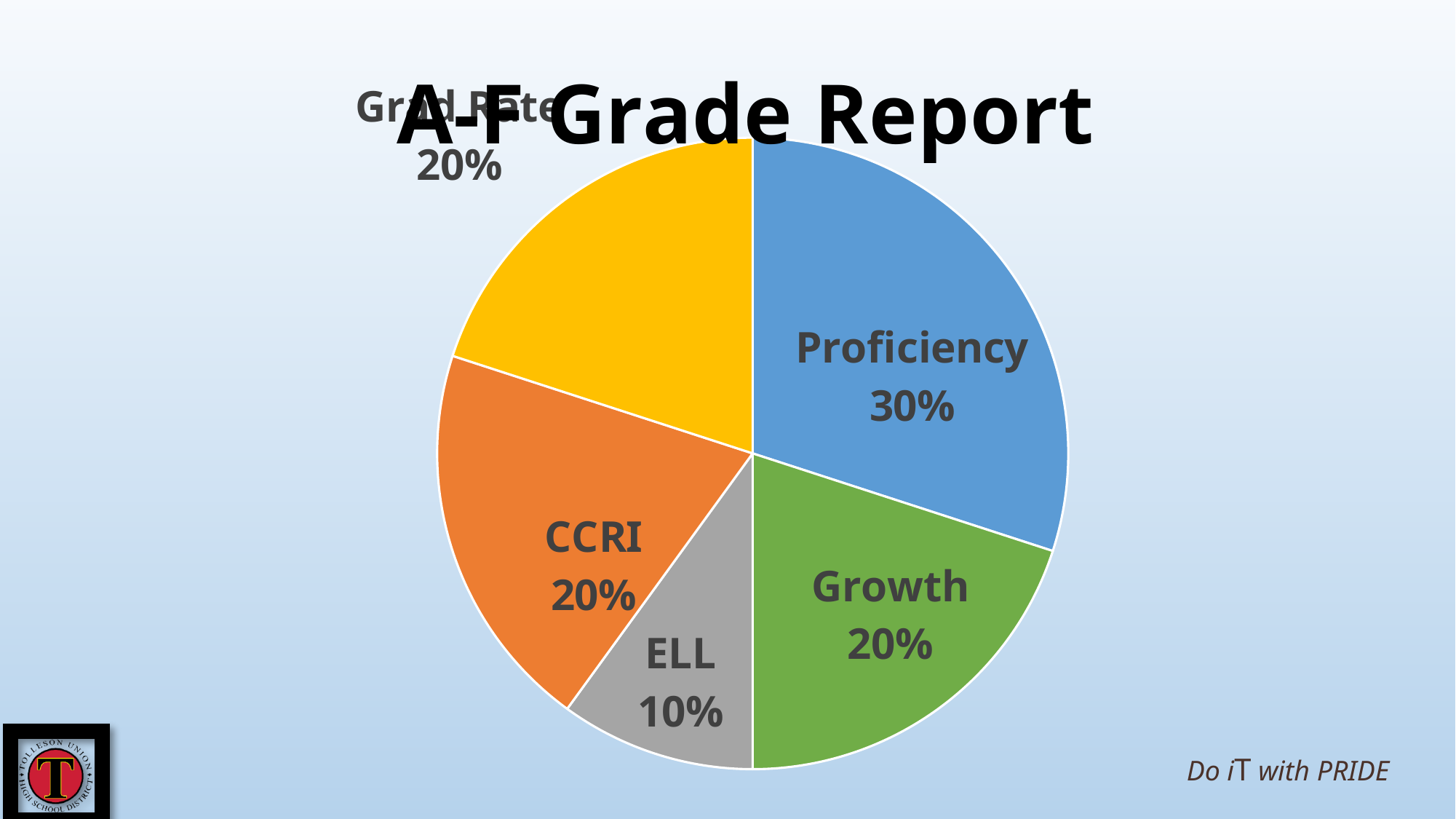
What colour is the Proficiency slice? blue What is the value for CCRI? 20% Which is larger, Proficiency or Growth? Proficiency What is the value for ELL? 10% How many slices does the pie chart have? 5 What is the value shown for the yellow slice (Grad Rate)? 20% Which category has the smallest share of the pie? ELL What is the difference between the Proficiency and ELL values? 20% What is the value for Proficiency? 30% What kind of chart is shown on the slide? pie chart Which category has the largest share of the pie? Proficiency What is the value for Growth? 20%